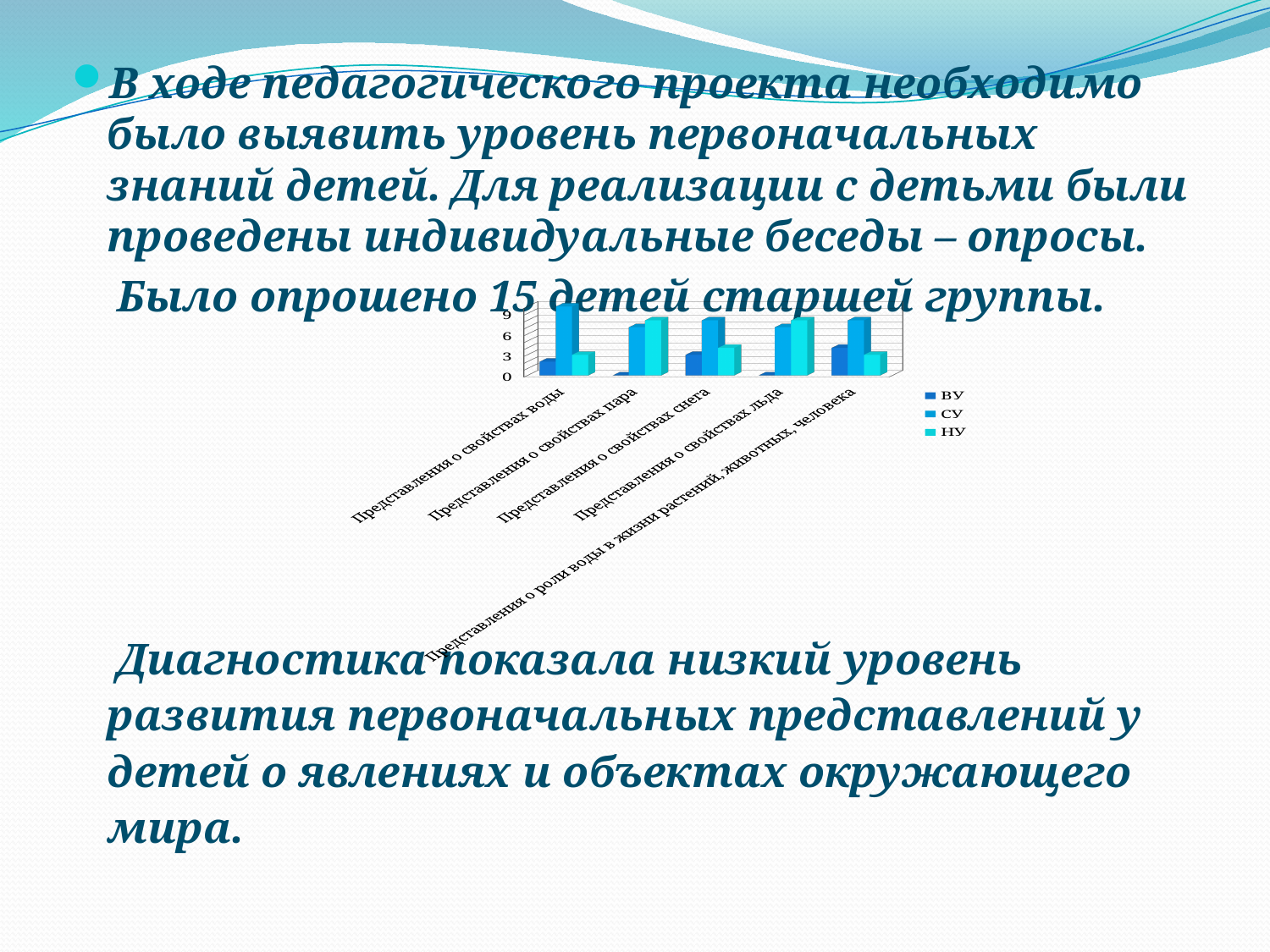
What kind of chart is shown on the slide? Bar chart Is the value of ВУ for "Представления о свойствах льда" greater or less than 3? less How many series does the chart's legend list? 3 What are the series names listed in the chart's legend? ВУ, СУ, НУ For "Представления о свойствах снега", which series has the larger value, СУ or ВУ? СУ Is the value of ВУ for "Представления о свойствах пара" greater or less than 3? less How many categories are shown on the x axis of the chart? 5 Is the value of НУ for "Представления о свойствах воды" greater or less than 6? less Which series has the highest value for "Представления о свойствах воды"? СУ For "Представления о свойствах воды", which series has the larger value, СУ or НУ? СУ